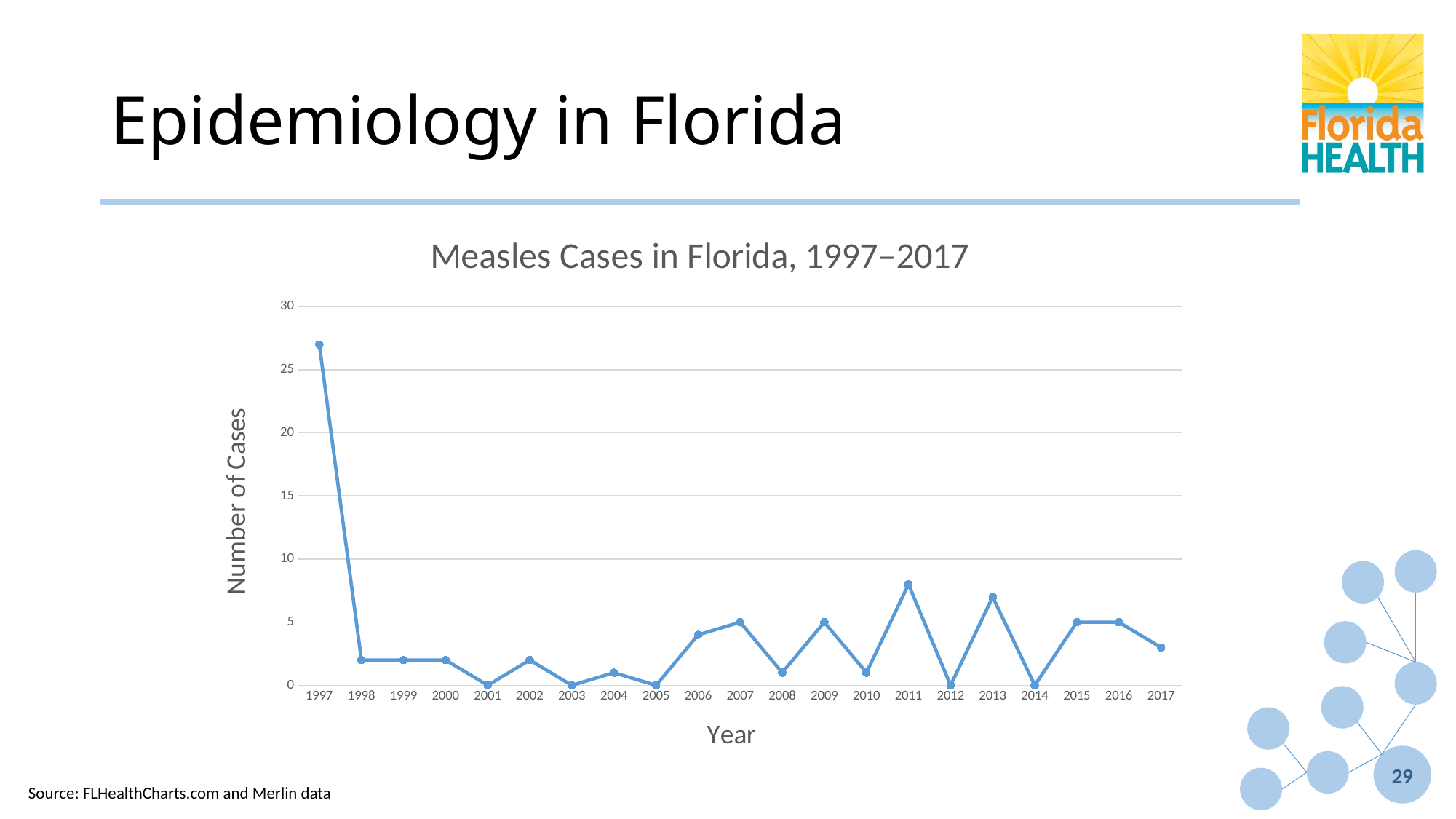
What is the number of cases in 2007? 5 What is the label of the vertical axis? Number of Cases Do the number of cases rise or fall from 1997 to 1998? fall What is the number of cases in 2012? 0 What kind of chart is shown on the slide? line chart How many years are plotted on the x axis? 21 Which year has the highest number of measles cases? 1997 What is the title of the chart? Measles Cases in Florida, 1997–2017 Is the value for 2011 greater or less than 10? less Which year has more cases, 2011 or 2012? 2011 What is the number of cases in 2015? 5 Is the value for 1997 greater or less than 25? greater